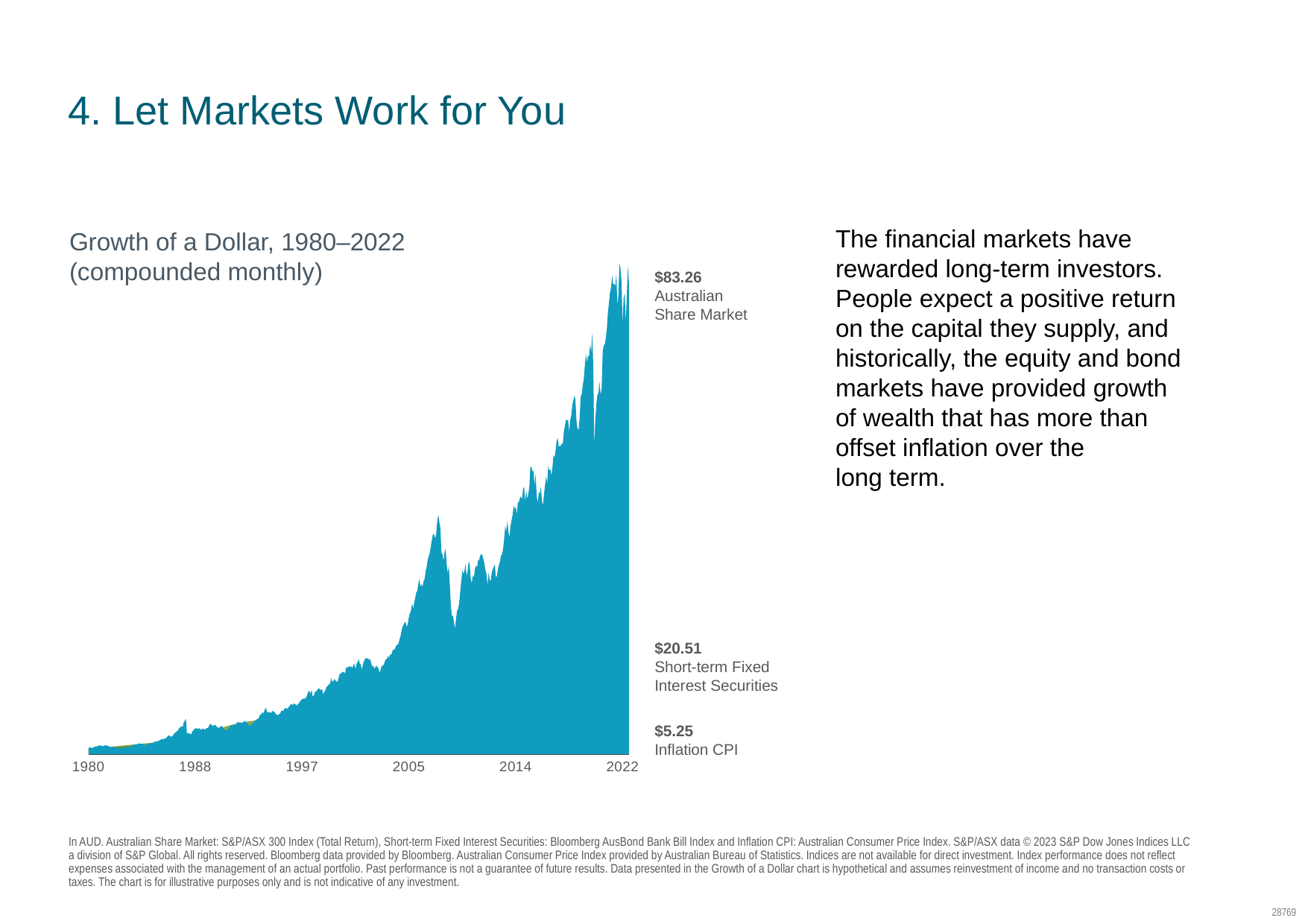
How many series are labelled in the Growth of a Dollar chart? 3 What kind of chart is the Growth of a Dollar chart? Area chart What is the ending value shown for Inflation CPI? $5.25 What is the ending value shown for the Australian Share Market in the Growth of a Dollar chart? $83.26 Which series has the highest ending value in the Growth of a Dollar chart? Australian Share Market Which series has the lowest ending value in the Growth of a Dollar chart? Inflation CPI What is the difference between the ending values of Short-term Fixed Interest Securities and Inflation CPI? $15.26 Which ended higher, Short-term Fixed Interest Securities or Inflation CPI? Short-term Fixed Interest Securities What is the difference between the ending values of the Australian Share Market and Short-term Fixed Interest Securities? $62.75 What is the ending value shown for Short-term Fixed Interest Securities? $20.51 Does the Australian Share Market value generally rise or fall from 1980 to 2022? Rise What is the first year and the last year shown on the x axis of the chart? 1980 and 2022